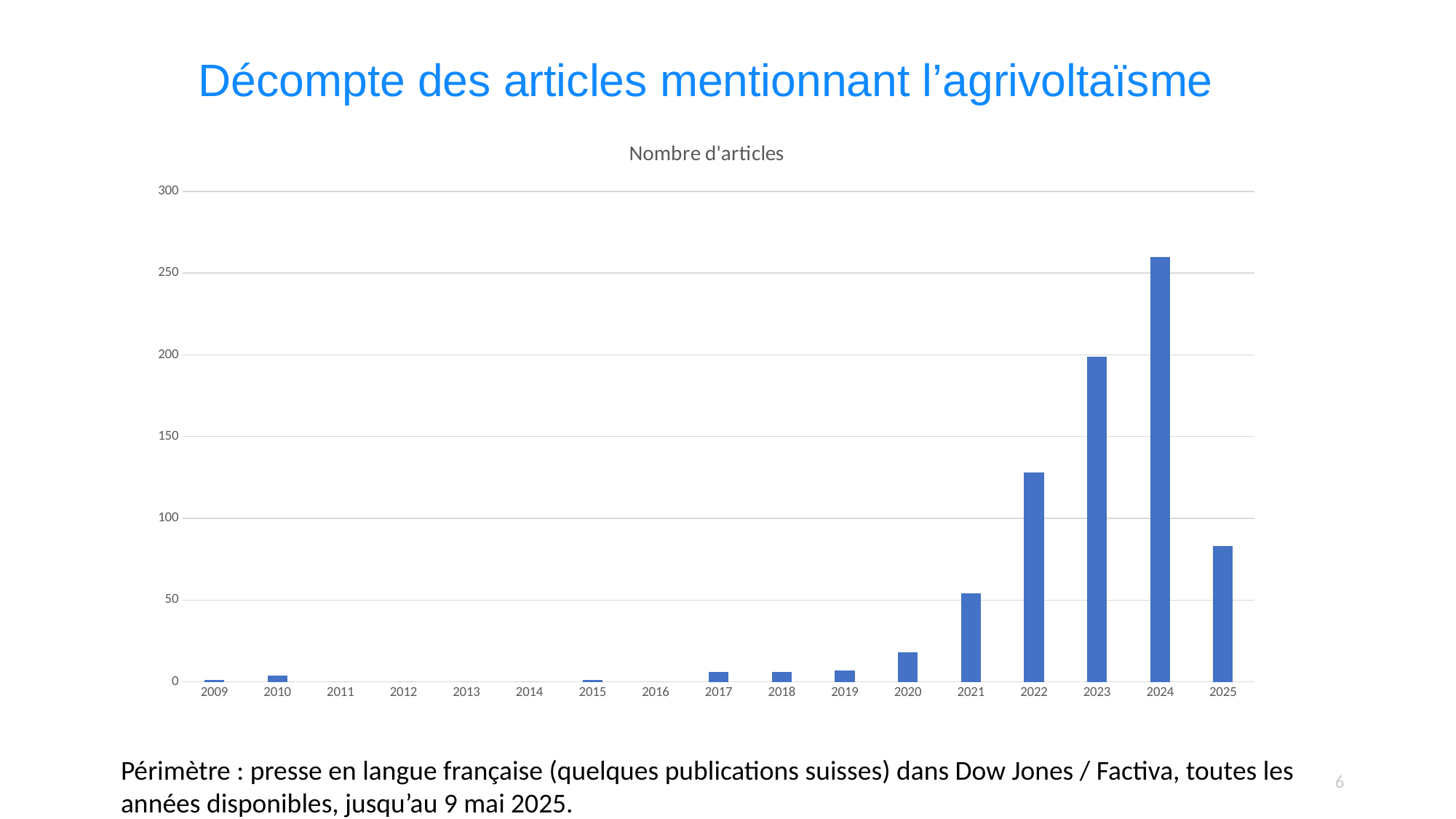
Do the values rise or fall from 2020 to 2024? rise Is the value for 2023 greater or less than 150? greater Which year has more articles, 2022 or 2025? 2022 How many years are shown on the x axis of the chart? 17 Is the value for 2020 greater or less than 50? less Is the value for 2024 greater or less than 250? greater What kind of chart is shown on the slide? bar chart What is the title shown above the chart? Nombre d'articles Which year has the highest number of articles? 2024 Which year has more articles, 2023 or 2024? 2024